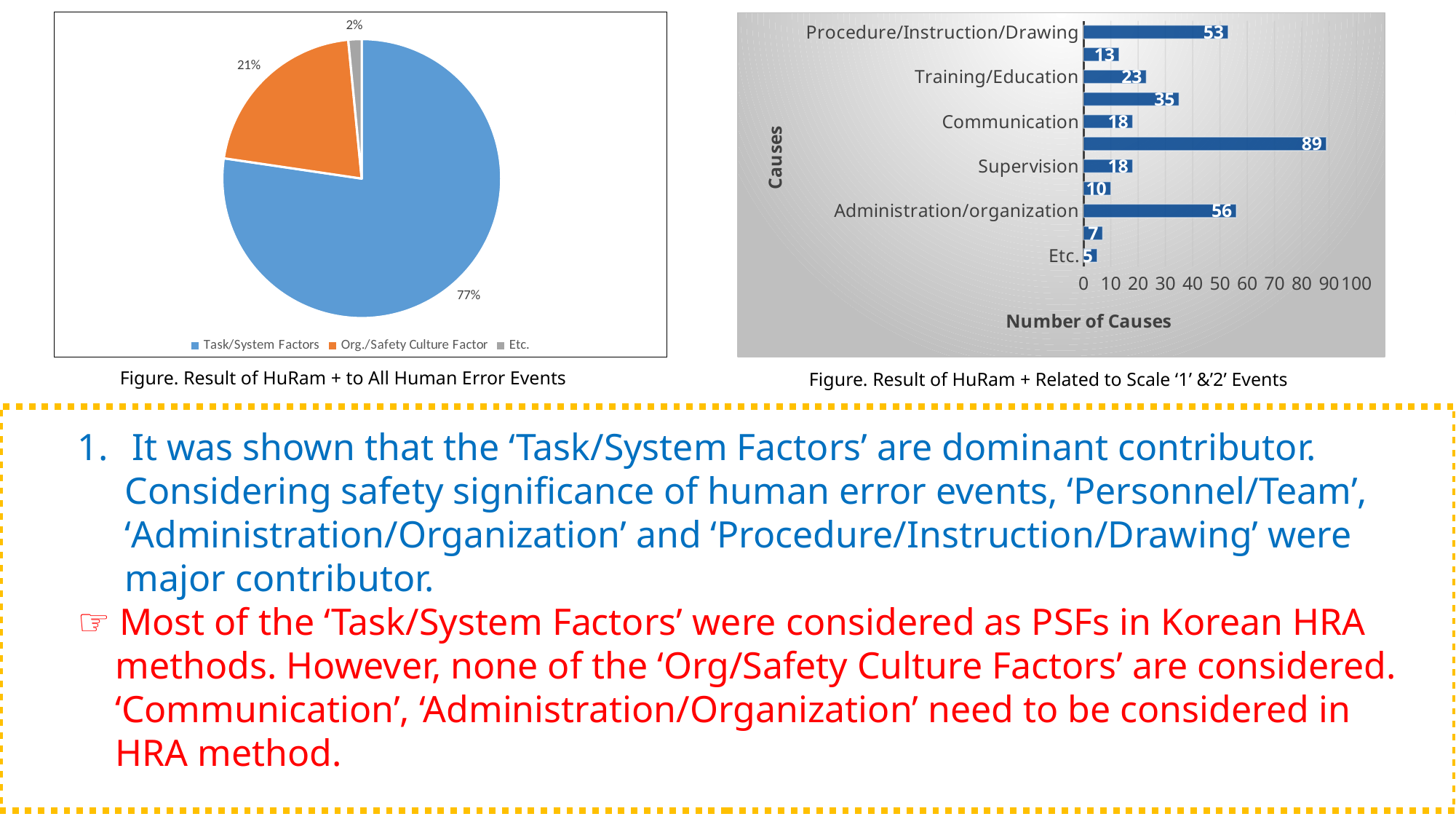
In the bar chart on the right, which labeled category has the lowest value? Etc. What kind of chart is the chart on the right? Bar chart In the bar chart on the right, which is larger, the value for Administration/organization or the value for Procedure/Instruction/Drawing? Administration/organization In the pie chart on the left, what is the difference in percentage points between Task/System Factors and Org./Safety Culture Factor? 56 In the bar chart on the right, what is the value for Procedure/Instruction/Drawing? 53 In the pie chart on the left, how many categories does the legend list? 3 In the bar chart on the right, what is the value for Administration/organization? 56 In the pie chart on the left, what percentage is shown for Org./Safety Culture Factor? 21% In the bar chart on the right, what is the title of the horizontal axis? Number of Causes In the bar chart on the right, what is the value for Training/Education? 23 In the pie chart on the left, which category has the smallest slice? Etc. In the pie chart on the left, what share of the pie is Task/System Factors? 77%